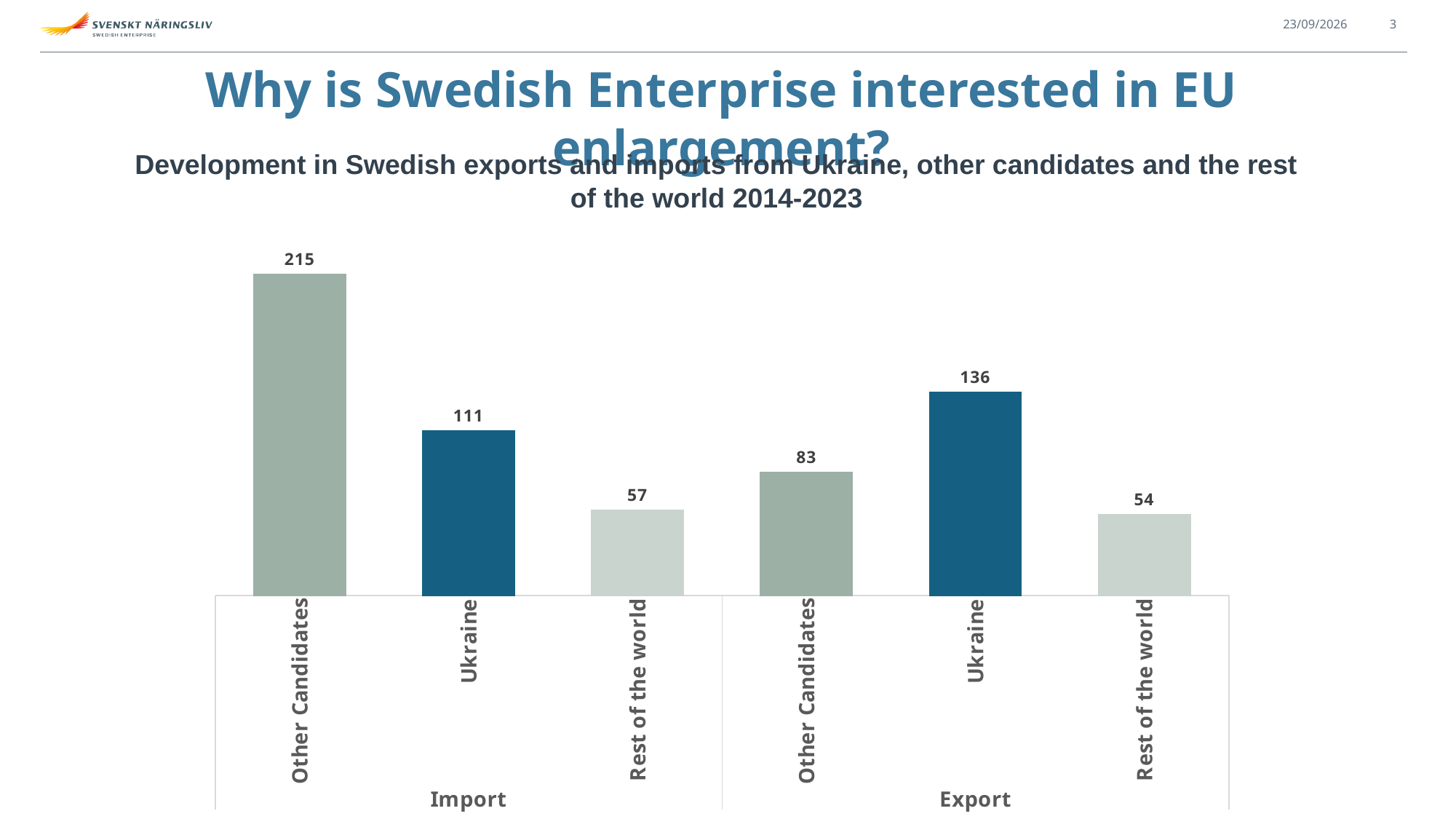
What is the value for Rest of the world under Import? 57 Which is larger: Ukraine under Import or Other Candidates under Export? Ukraine under Import What is the value for Ukraine under Export? 136 What are the two groups into which the categories are divided on the x axis? Import and Export What is the value for Other Candidates under Export? 83 What is the difference between the Import and Export values for Ukraine? 25 What kind of chart is shown on the slide? Bar chart How many bars are plotted on the chart? 6 Which bar has the highest value on the chart? Other Candidates (Import) What is the value for Other Candidates under Import? 215 What is the difference between Other Candidates under Import and Other Candidates under Export? 132 Which bar has the lowest value on the chart? Rest of the world (Export)